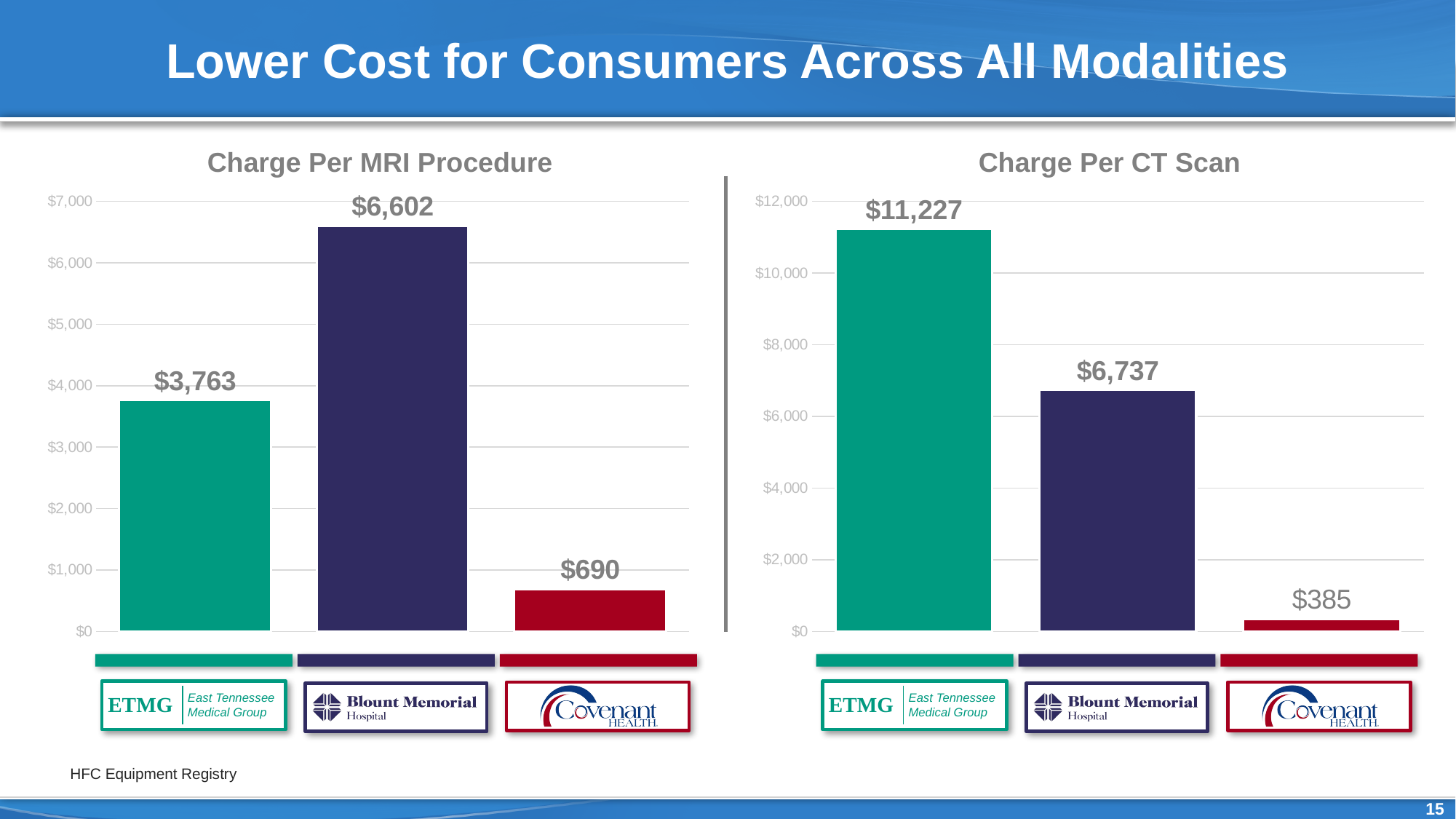
In the Charge Per MRI Procedure chart, which provider has the highest charge? Blount Memorial Hospital In the Charge Per MRI Procedure chart, what is the charge for Covenant Health? $690 In the Charge Per CT Scan chart, what is the charge for Covenant Health? $385 In the Charge Per CT Scan chart, what is the difference between the ETMG charge and the Blount Memorial Hospital charge? $4,490 In the Charge Per CT Scan chart, what is the charge for East Tennessee Medical Group (ETMG)? $11,227 In the Charge Per MRI Procedure chart, what is the charge for Blount Memorial Hospital? $6,602 In the Charge Per MRI Procedure chart, what is the difference between the Blount Memorial Hospital charge and the ETMG charge? $2,839 How many providers are shown in the Charge Per CT Scan chart? 3 In the Charge Per MRI Procedure chart, is the value for ETMG greater or less than $4,000? less In the Charge Per CT Scan chart, which provider has the lowest charge? Covenant Health In the Charge Per CT Scan chart, which is larger: the charge for ETMG or the charge for Blount Memorial Hospital? ETMG What type of chart is the Charge Per MRI Procedure chart? Bar chart